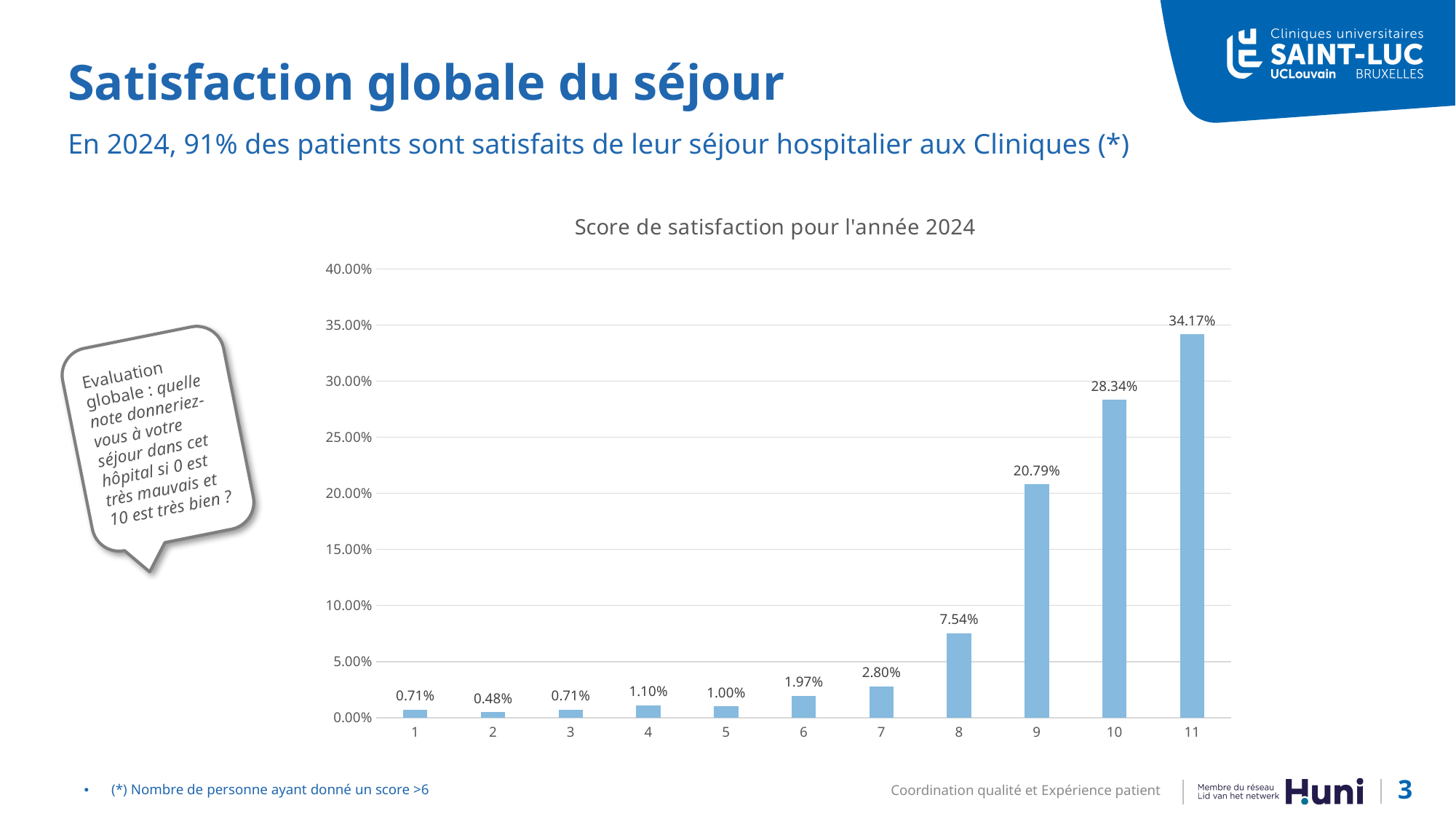
Do the values generally rise or fall from category 6 to category 11? rise How many categories are shown on the x axis of the chart? 11 What kind of chart is shown on the slide? bar chart Which category has the lowest value in the chart? 2 Which is larger, the value for category 8 or the value for category 9? 9 Which category has the highest value in the chart? 11 What is the value for category 11 in the chart? 34.17% What is the difference between the values for categories 11 and 10? 5.83% What is the title of the chart? Score de satisfaction pour l'année 2024 What is the value for category 2 in the chart? 0.48% What is the value for category 9 in the chart? 20.79% Is the value for category 10 greater or less than 25.00%? greater